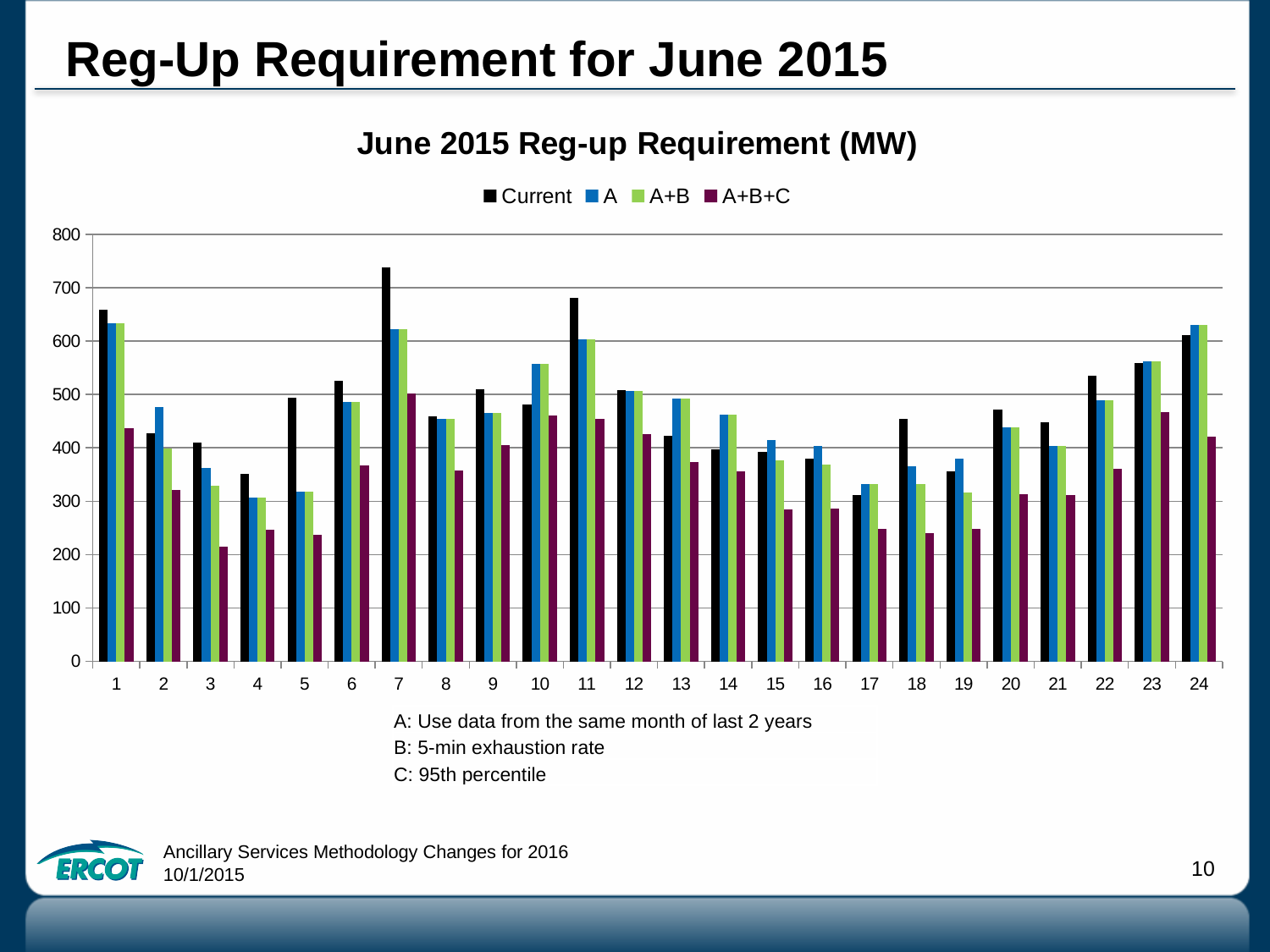
Which is larger for the Current series: hour 7 or hour 11? hour 7 Is the A+B+C value for hour 3 greater or less than 300? less For the A+B+C series, which hour has the lowest Reg-up requirement? 3 How many series does the legend list? 4 What kind of chart is shown on the slide? bar chart How many hour categories are shown on the x axis? 24 For the Current series, which hour has the highest Reg-up requirement? 7 What is the title of the chart? June 2015 Reg-up Requirement (MW) Is the A value for hour 24 greater or less than 600? greater Is the Current value for hour 17 greater or less than 400? less At hour 2, which is larger: the Current value or the A value? A